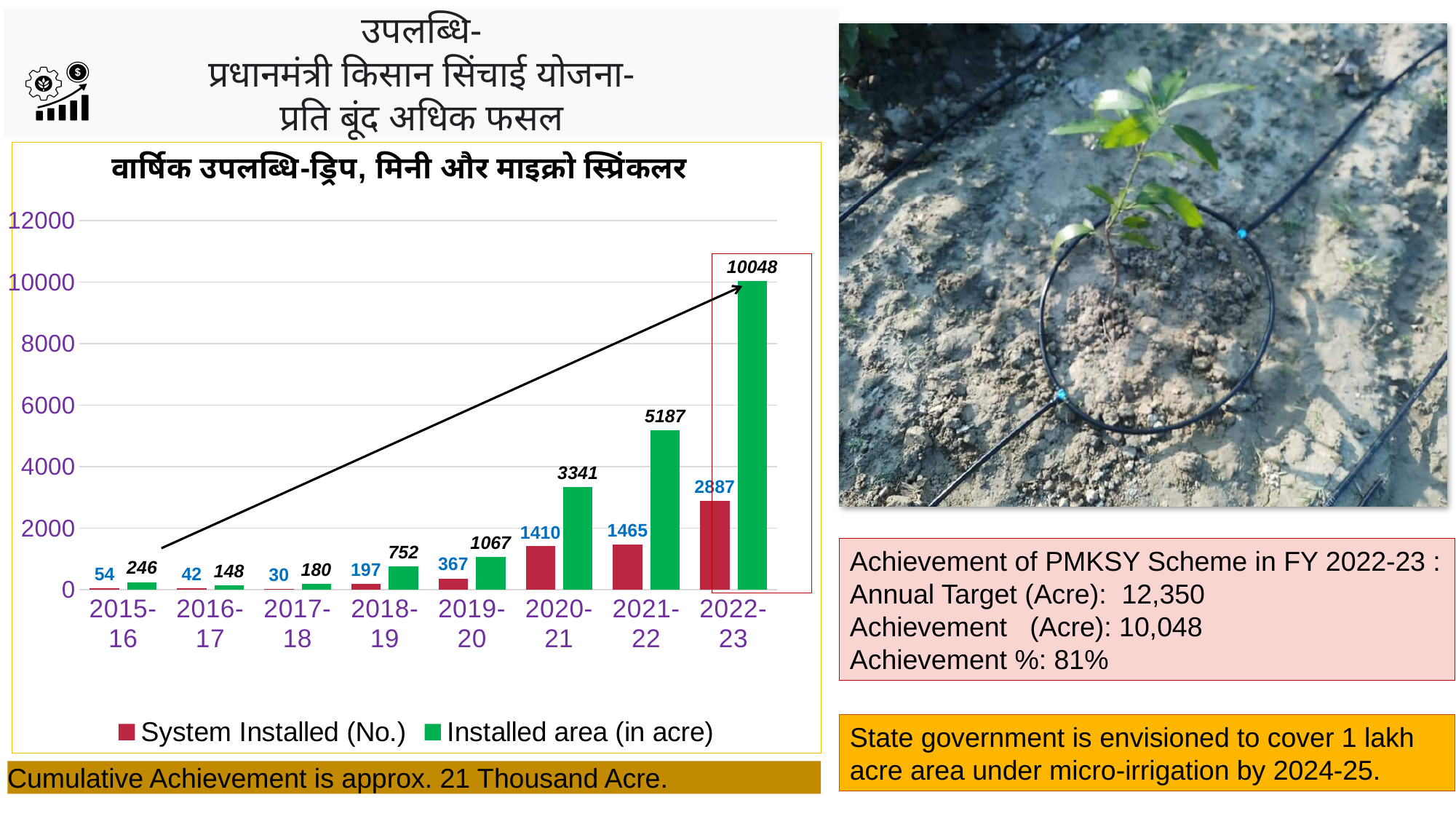
How many systems were installed (System Installed (No.)) in 2020-21? 1410 What is the Installed area (in acre) for 2022-23? 10048 What is the difference between the Installed area (in acre) in 2022-23 and 2021-22? 4861 What kind of chart is shown on the slide? Bar chart Which colour represents the Installed area (in acre) series in the chart? Green What is the Installed area (in acre) for 2015-16? 246 Which is larger: the System Installed (No.) in 2021-22 or in 2020-21? 2021-22 How many years are shown on the x axis of the chart? 8 How many series does the chart legend list? 2 Which year has the lowest System Installed (No.) value? 2017-18 Does the Installed area (in acre) generally rise or fall from 2017-18 to 2022-23? Rise Which year has the highest Installed area (in acre)? 2022-23